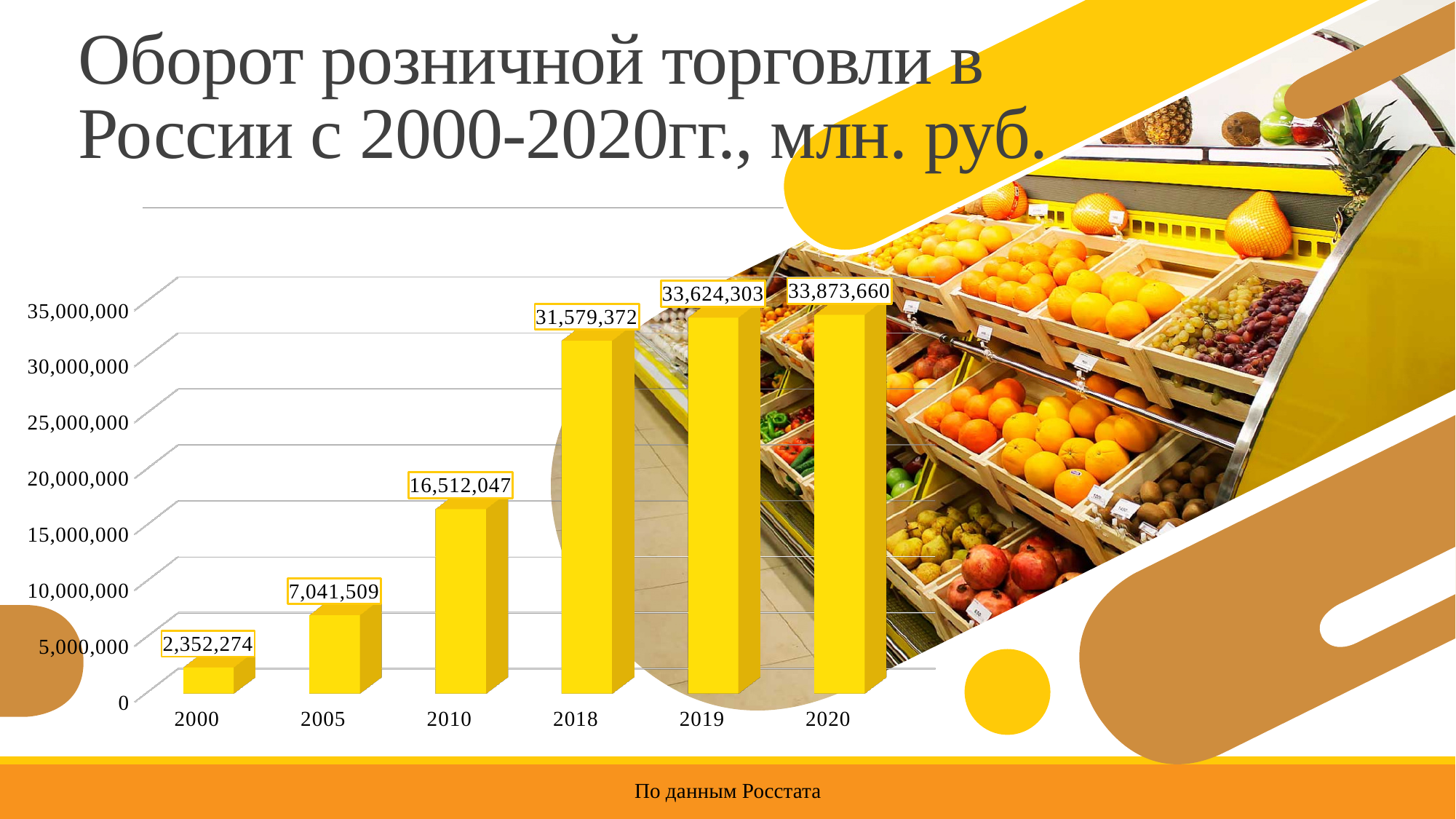
What value is shown for 2019? 33,624,303 What is the retail trade turnover value shown for 2000? 2,352,274 Which year has the highest value on the chart? 2020 What is the difference between the values for 2020 and 2019? 249,357 Which is larger, the value for 2018 or the value for 2019? 2019 Which year has the lowest value on the chart? 2000 What is the difference between the values for 2010 and 2005? 9,470,538 What kind of chart is shown on the slide? bar chart What value is shown for 2010? 16,512,047 Do the values rise or fall from 2000 to 2020? rise Is the value for 2005 greater or less than 10,000,000? less How many years are shown on the x axis of the chart? 6